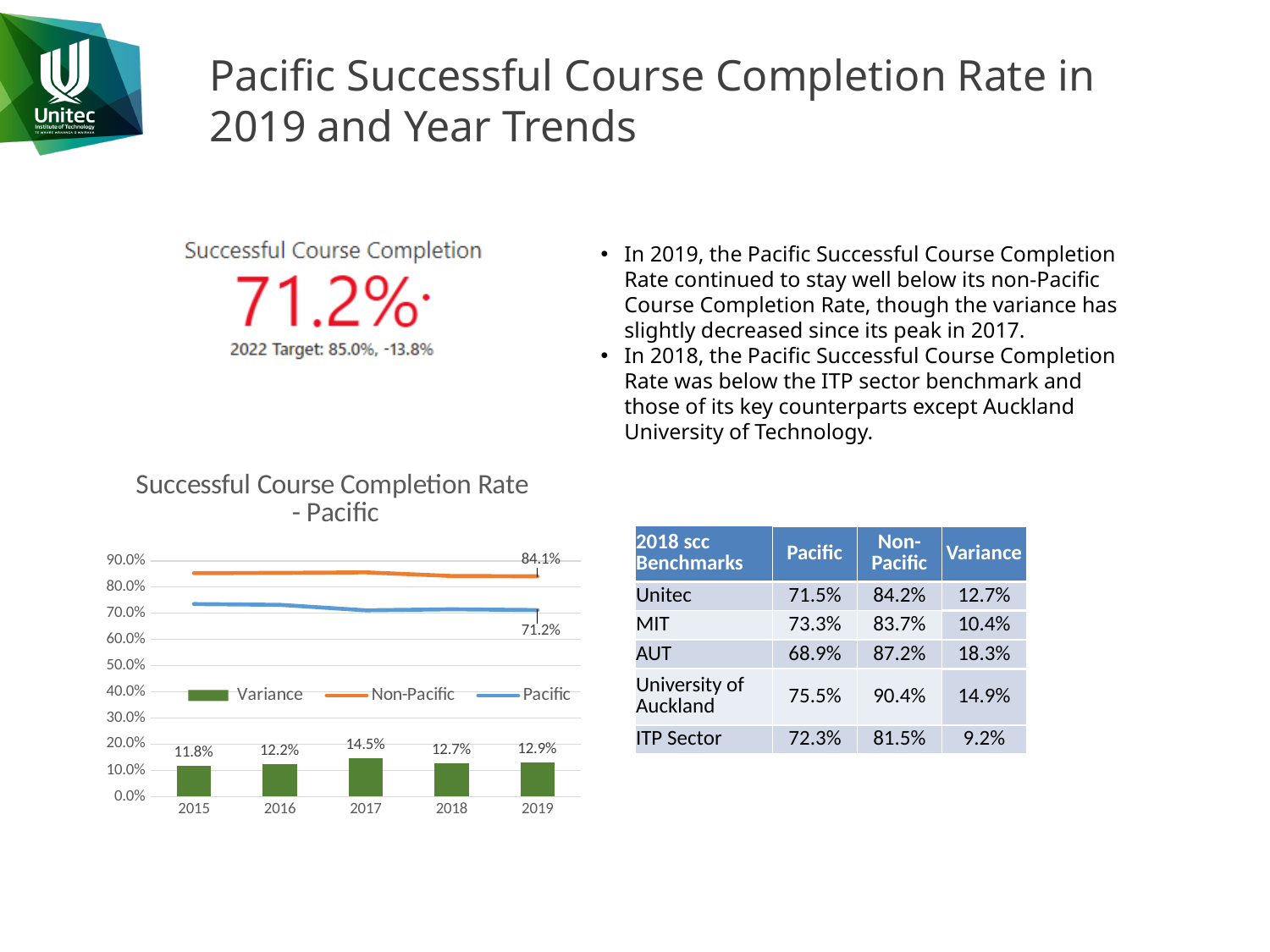
What is the Variance value for 2017 in the Successful Course Completion Rate - Pacific chart? 14.5% What is the Pacific successful course completion rate shown for 2019 in the chart? 71.2% How many years are shown on the x axis of the Successful Course Completion Rate - Pacific chart? 5 What is the Non-Pacific successful course completion rate shown for 2019 in the chart? 84.1% In which year is the Variance highest in the Successful Course Completion Rate - Pacific chart? 2017 What is the difference between the Non-Pacific and Pacific rates in 2019 according to the chart's data labels? 12.9% In which year is the Variance lowest in the Successful Course Completion Rate - Pacific chart? 2015 What is the difference between the Variance in 2017 and the Variance in 2016? 2.3% How many series does the legend of the Successful Course Completion Rate - Pacific chart list? 3 Is the Non-Pacific value for 2016 greater or less than 80.0%? greater Which is larger in 2018, the Variance or the Variance in 2019? 2019 What is the Variance value for 2015 in the Successful Course Completion Rate - Pacific chart? 11.8%